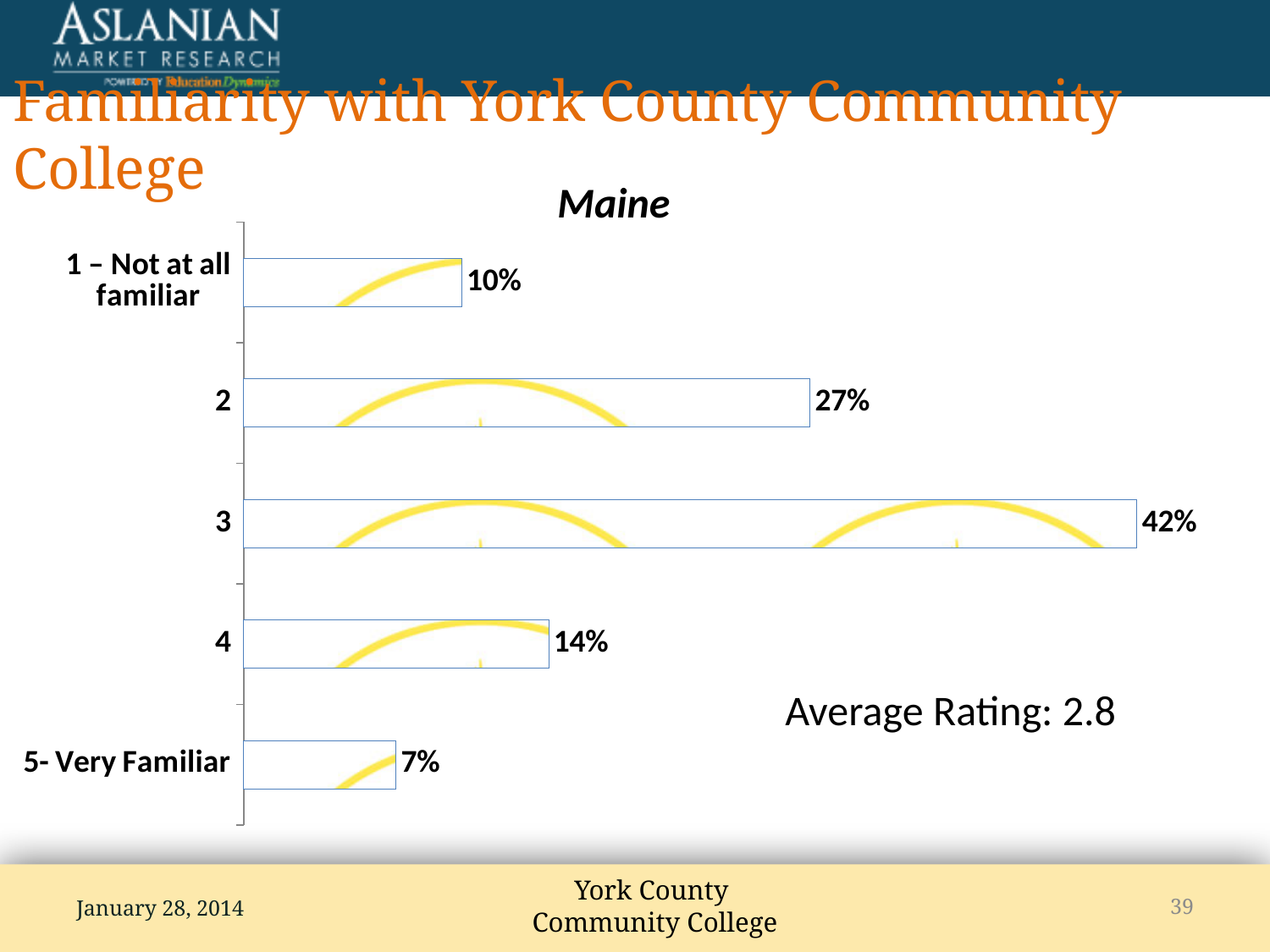
What is the difference between the percentage for rating 3 and the percentage for rating 2? 15% What type of chart is shown on the slide? Bar chart What average rating is stated on the slide? 2.8 What is the title of the chart? Maine Which familiarity rating has the highest percentage? 3 What is the difference between the percentage for rating 4 and the percentage for '5- Very Familiar'? 7% How many familiarity rating categories are shown in the chart? 5 Which has a larger percentage: rating 2 or rating 4? 2 What percentage of respondents rated themselves '5- Very Familiar'? 7% What percentage of respondents gave a familiarity rating of 3? 42% Which familiarity rating has the lowest percentage? 5- Very Familiar What percentage of respondents rated their familiarity as '1 – Not at all familiar'? 10%